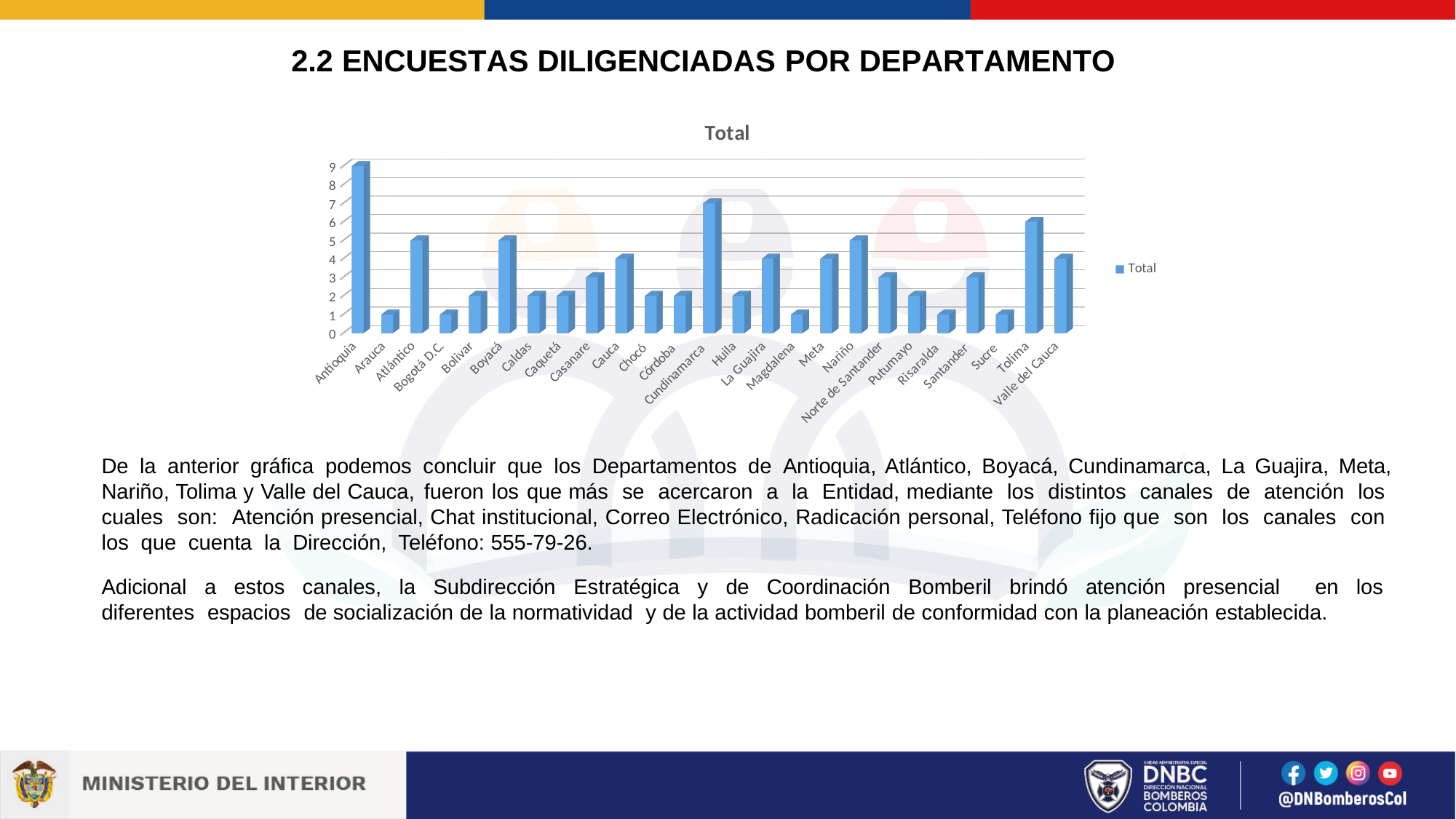
What is the title of the chart? Total Is the value for Nariño greater or less than 3? greater What type of chart is shown on the slide? Bar chart What is the value for Antioquia? 9 Is the value for Sucre greater or less than 3? less How many series does the legend list? 1 Which is larger, the value for Cundinamarca or the value for Tolima? Cundinamarca What is the difference between the values for Antioquia and Cundinamarca? 2 What is the value for Tolima? 6 Which department has the highest value in the chart? Antioquia How many departments are shown on the x axis of the chart? 25 What is the value for Cundinamarca? 7